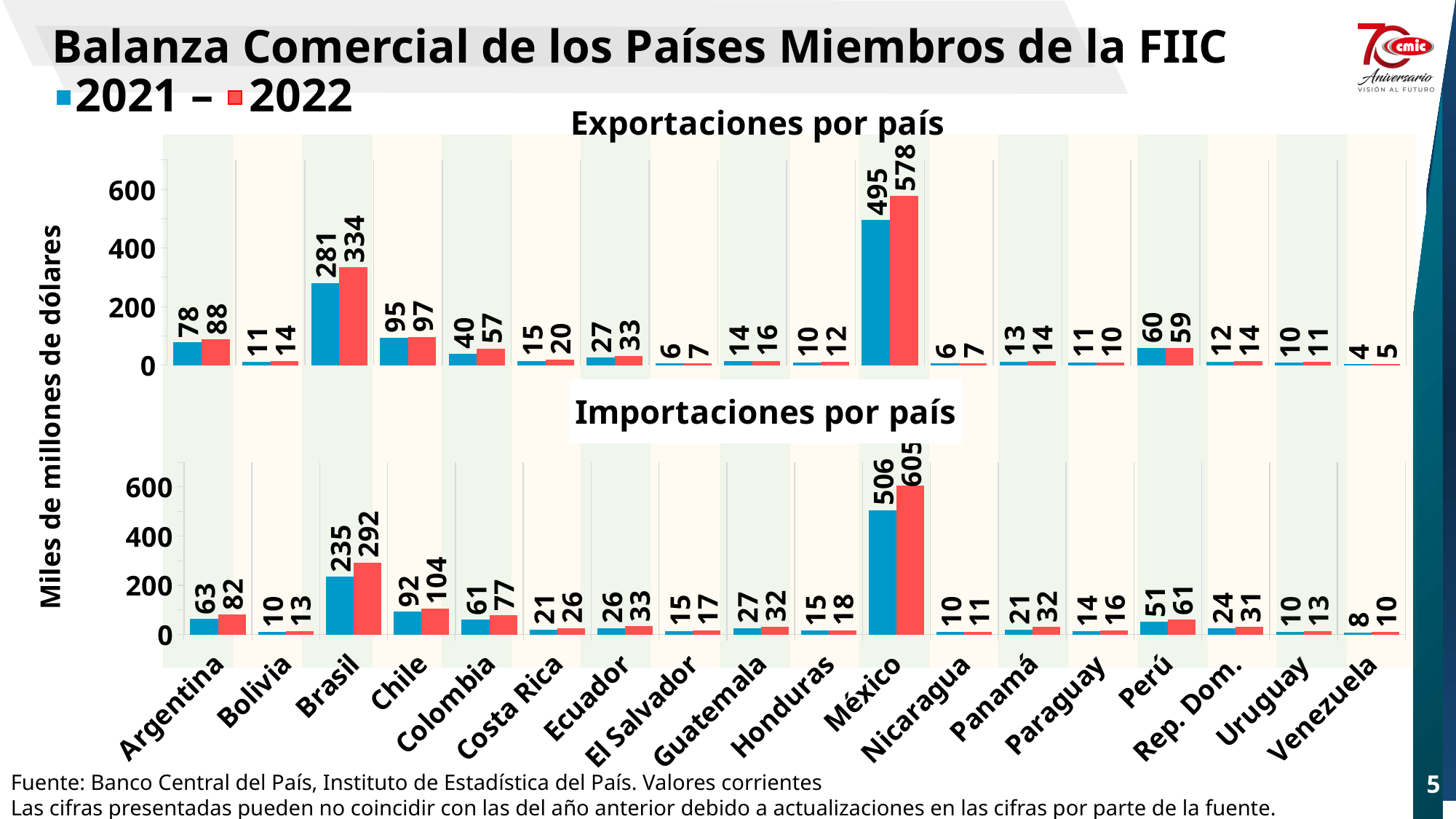
What is the y-axis label shared by the two charts on the slide? Miles de millones de dólares In the 'Importaciones por país' chart, what is the difference between the 2022 values for Argentina and Chile? 22 In the 'Exportaciones por país' chart, which country has the lowest 2021 value? Venezuela How many series does the legend list for the charts on this slide? 2 In the 'Importaciones por país' chart, what is the value for Brasil in 2021? 235 In the 'Importaciones por país' chart, what is the difference between the 2022 and 2021 values for México? 99 In the 'Importaciones por país' chart, is the 2022 value for Brasil greater or less than 200? greater In the 'Exportaciones por país' chart, which country has the highest 2022 value? México In the 'Exportaciones por país' chart, what is the value for México in 2022? 578 What kind of chart is 'Exportaciones por país'? Bar chart How many countries are shown on the x axis of the 'Importaciones por país' chart? 18 In the 'Exportaciones por país' chart, which is larger for Perú: the 2021 value or the 2022 value? 2021